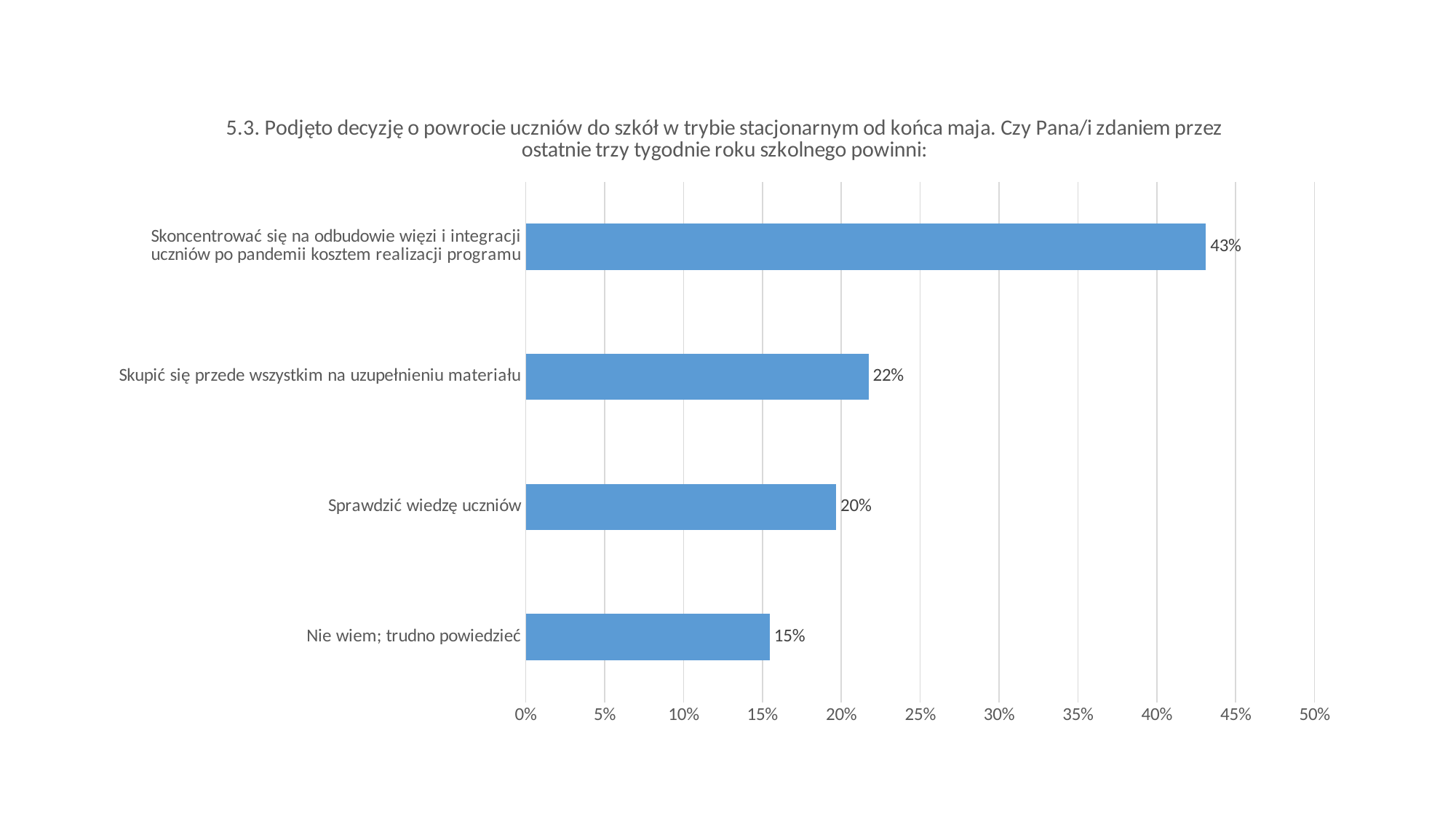
What is the value for "Skupić się przede wszystkim na uzupełnieniu materiału"? 22% What kind of chart is shown on the slide? Bar chart What is the value for "Nie wiem; trudno powiedzieć"? 15% Which category has the lowest value? Nie wiem; trudno powiedzieć Which category has the highest value? Skoncentrować się na odbudowie więzi i integracji uczniów po pandemii kosztem realizacji programu What is the maximum value shown on the horizontal axis? 50% How many categories are shown in the chart? 4 What is the value for "Sprawdzić wiedzę uczniów"? 20% What is the difference between the values for "Sprawdzić wiedzę uczniów" and "Nie wiem; trudno powiedzieć"? 5% Which is larger: the value for "Skupić się przede wszystkim na uzupełnieniu materiału" or the value for "Nie wiem; trudno powiedzieć"? Skupić się przede wszystkim na uzupełnieniu materiału What is the difference between the values for "Skoncentrować się na odbudowie więzi i integracji uczniów po pandemii kosztem realizacji programu" and "Skupić się przede wszystkim na uzupełnieniu materiału"? 21% What is the value for "Skoncentrować się na odbudowie więzi i integracji uczniów po pandemii kosztem realizacji programu"? 43%